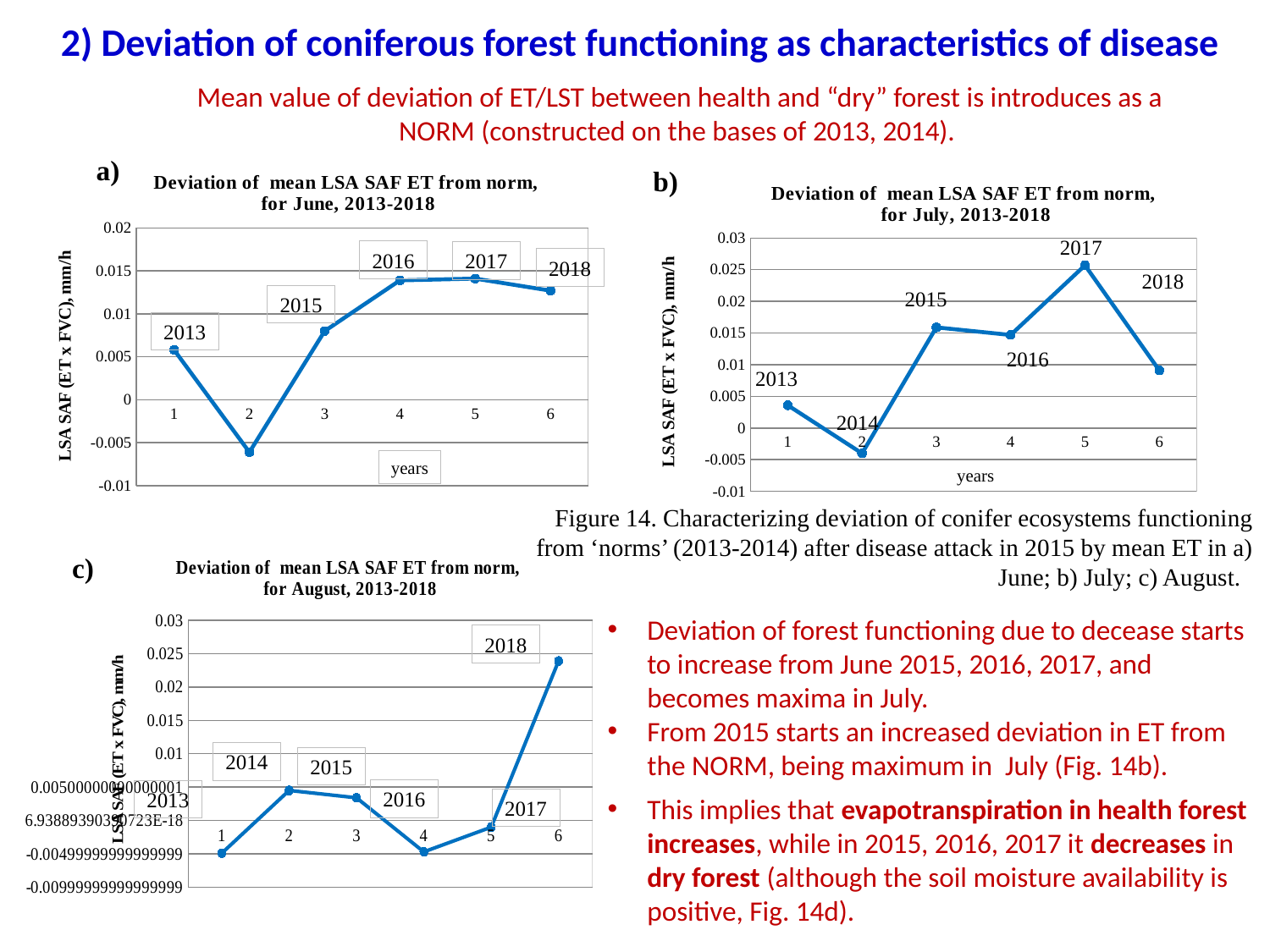
On the July chart (b), which is larger, the value for 2017 or the value for 2013? 2017 On the August chart (c), which year has the highest deviation value? 2018 How many data points are plotted on the 'Deviation of mean LSA SAF ET from norm, for July, 2013-2018' chart? 6 On the July chart (b), is the value for 2017 greater or less than 0.02? greater On the June chart (a), which year has the lowest deviation value? 2014 What kind of chart is the 'Deviation of mean LSA SAF ET from norm, for June, 2013-2018' chart? line chart On the August chart (c), is the value for 2018 greater or less than 0.02? greater On the July chart (b), which year has the highest deviation value? 2017 On the July chart (b), which year has the lowest deviation value? 2014 On the June chart (a), is the value for 2016 greater or less than 0.01? greater What is the y-axis label on the June chart (a)? LSA SAF (ET x FVC), mm/h